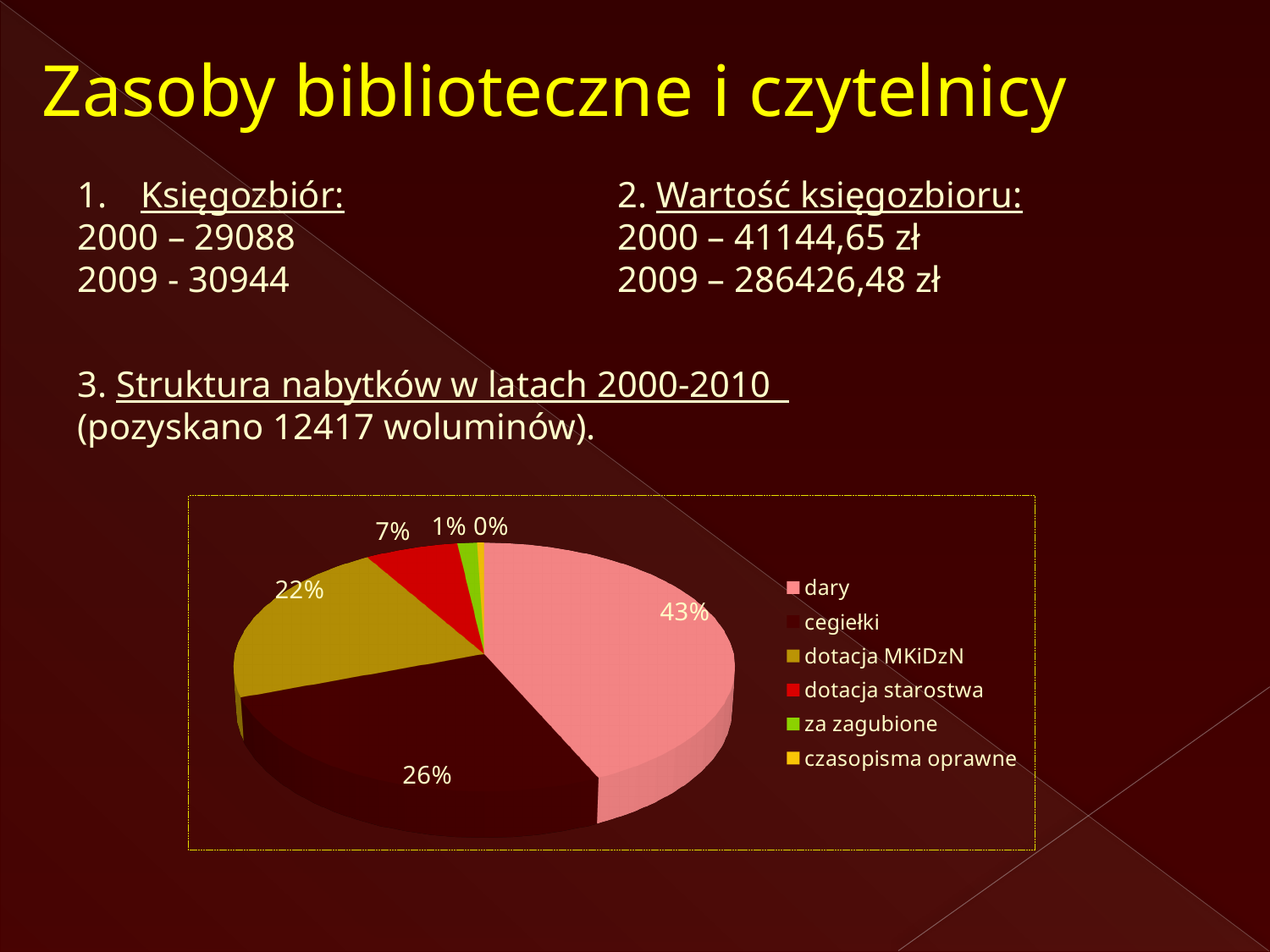
How many categories does the legend of the pie chart list? 6 What share of the pie does "dary" represent? 43% What kind of chart is shown on the slide? pie chart What share of the pie does "cegiełki" represent? 26% What colour is the slice for "dary" in the pie chart? pink What is the difference in percentage points between the shares of "dary" and "cegiełki"? 17 Which has a larger share, "dotacja MKiDzN" or "dotacja starostwa"? dotacja MKiDzN What share of the pie does "dotacja starostwa" represent? 7% What share of the pie does "za zagubione" represent? 1% Which category has the largest share of the pie? dary Which category has the smallest share of the pie? czasopisma oprawne What share of the pie does "dotacja MKiDzN" represent? 22%